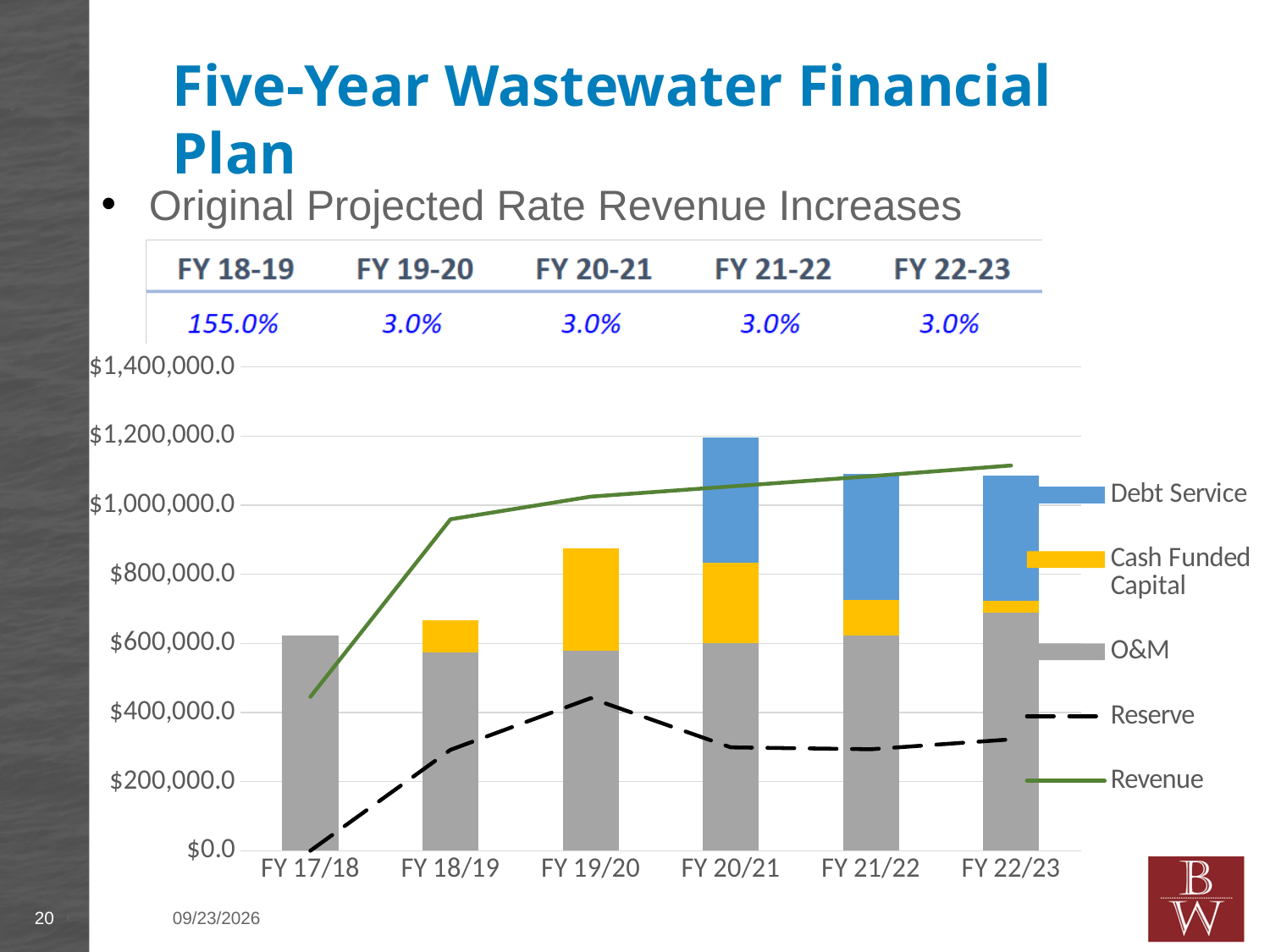
Which fiscal year has the tallest stacked bar? FY 20/21 Is the total stacked bar for FY 17/18 greater or less than $800,000.0? less How many fiscal years are shown along the x axis of the chart? 6 Is the Reserve value for FY 19/20 greater or less than $600,000.0? less What kind of chart is shown on the slide? A combination of a stacked bar chart and line chart Is the total stacked bar for FY 19/20 larger or smaller than the total stacked bar for FY 18/19? larger Which fiscal year has the shortest stacked bar? FY 17/18 Is the total stacked bar for FY 20/21 greater or less than $1,000,000.0? greater Which series in the legend is drawn as a dashed line? Reserve Does the Revenue line rise or fall from FY 17/18 to FY 22/23? rise How many series does the chart legend list? 5